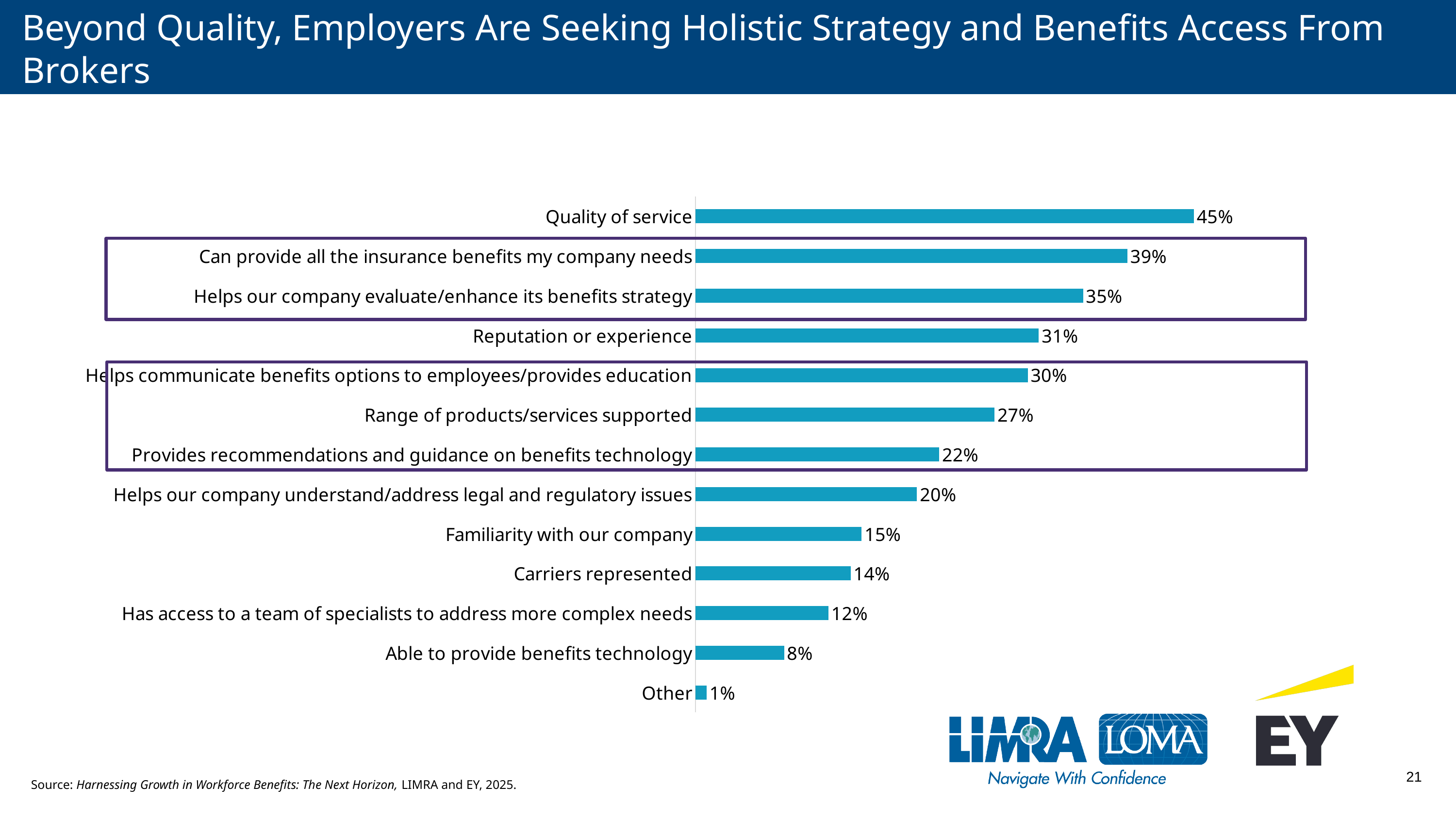
What kind of chart is shown on the slide? Bar chart What percentage is shown for Carriers represented? 14% What is the difference between Quality of service and Can provide all the insurance benefits my company needs? 6% Which category has the lowest value? Other What percentage is shown for Quality of service? 45% Which category has the highest value? Quality of service What is the value for Able to provide benefits technology? 8% How many categories are shown in the chart? 13 What is the difference between Reputation or experience and Familiarity with our company? 16% How many categories are enclosed in the two outlined boxes on the chart? 5 What is the value for Helps our company evaluate/enhance its benefits strategy? 35% Which is larger: Range of products/services supported or Provides recommendations and guidance on benefits technology? Range of products/services supported